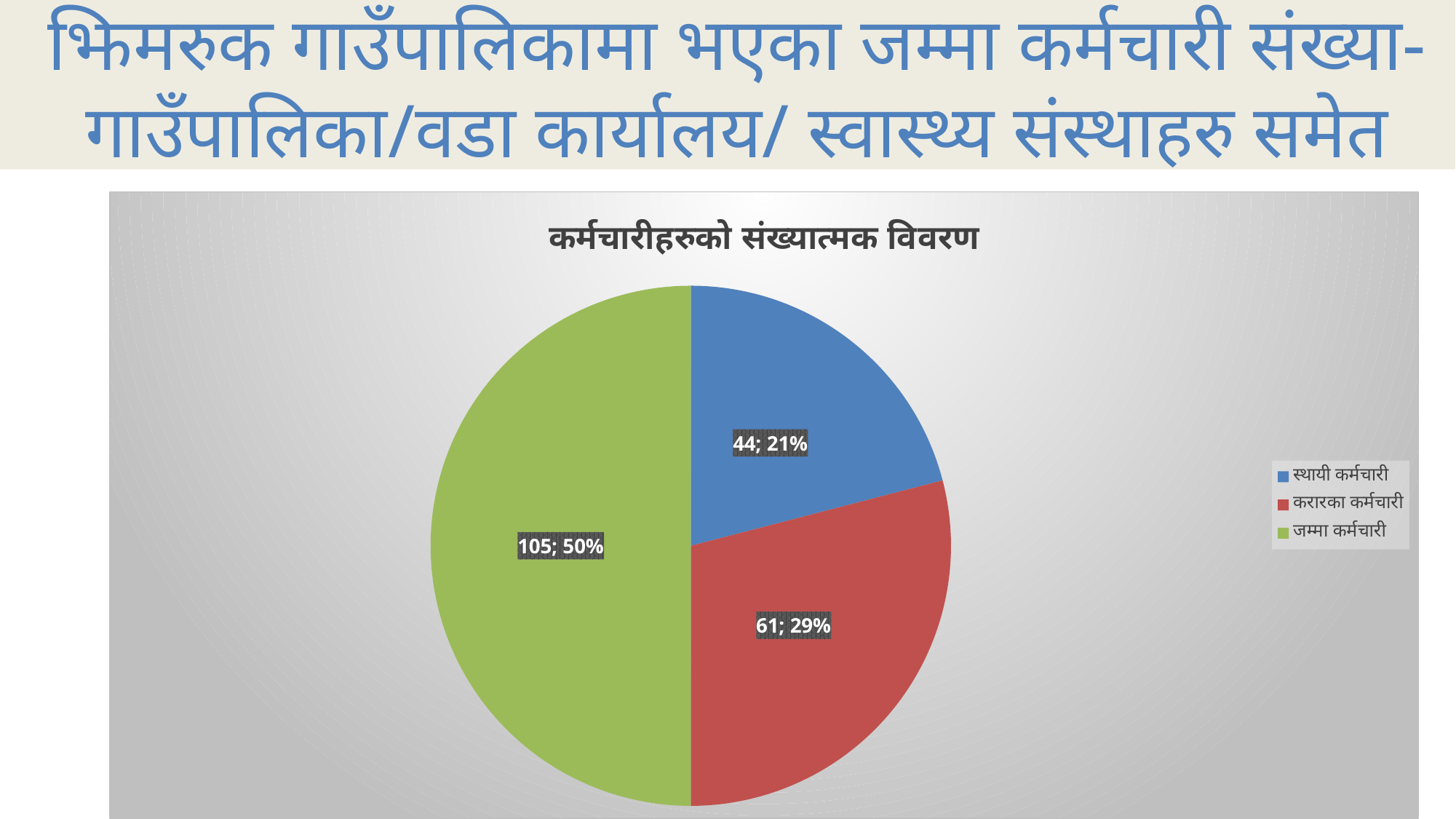
Which category has the largest slice? जम्मा कर्मचारी How many entries does the legend list? 3 What kind of chart is shown on the slide? pie chart What is the title of the chart? कर्मचारीहरुको संख्यात्मक विवरण What is the difference between the values for करारका कर्मचारी and स्थायी कर्मचारी? 17 What is the value for स्थायी कर्मचारी? 44 What is the value for करारका कर्मचारी? 61 What is the value for जम्मा कर्मचारी? 105 What share of the pie does जम्मा कर्मचारी represent? 50% What share of the pie does स्थायी कर्मचारी represent? 21% Which category has the smallest slice? स्थायी कर्मचारी How many slices does the pie chart have? 3